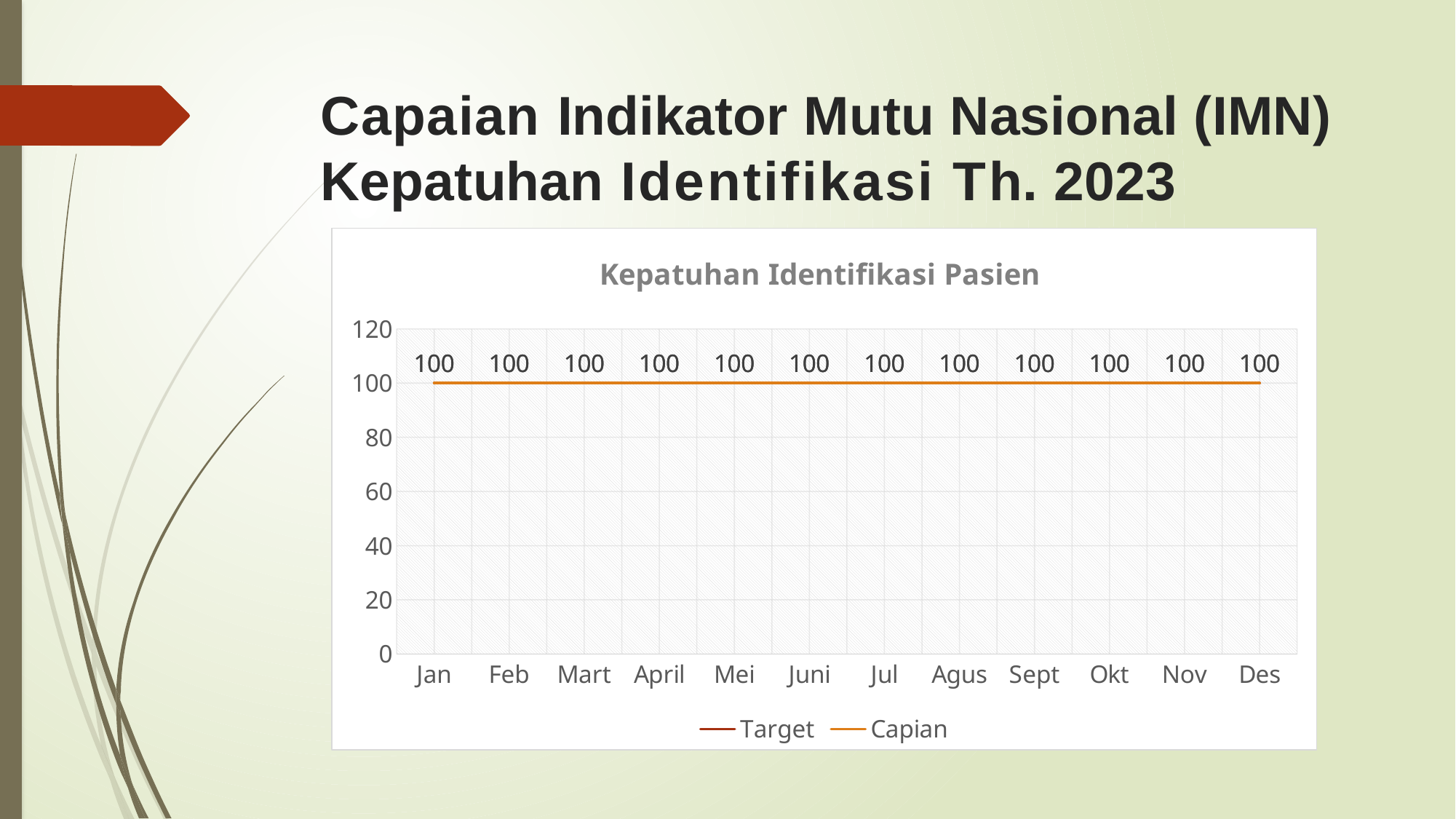
How many months are plotted along the x axis of the chart? 12 What are the two series named in the chart legend? Target and Capian What is the value shown for Sept in the Kepatuhan Identifikasi Pasien chart? 100 What is the value shown for Jan in the Kepatuhan Identifikasi Pasien chart? 100 Do the plotted values rise, fall, or stay flat from Jan to Des? Stay flat What is the value shown for Des in the Kepatuhan Identifikasi Pasien chart? 100 What is the difference between the values for Jan and Des? 0 What is the value shown for Juni in the Kepatuhan Identifikasi Pasien chart? 100 What is the title of the chart? Kepatuhan Identifikasi Pasien What kind of chart is shown on the slide? Line chart Is the value for Mart greater or less than 80? greater How many series does the chart legend list? 2